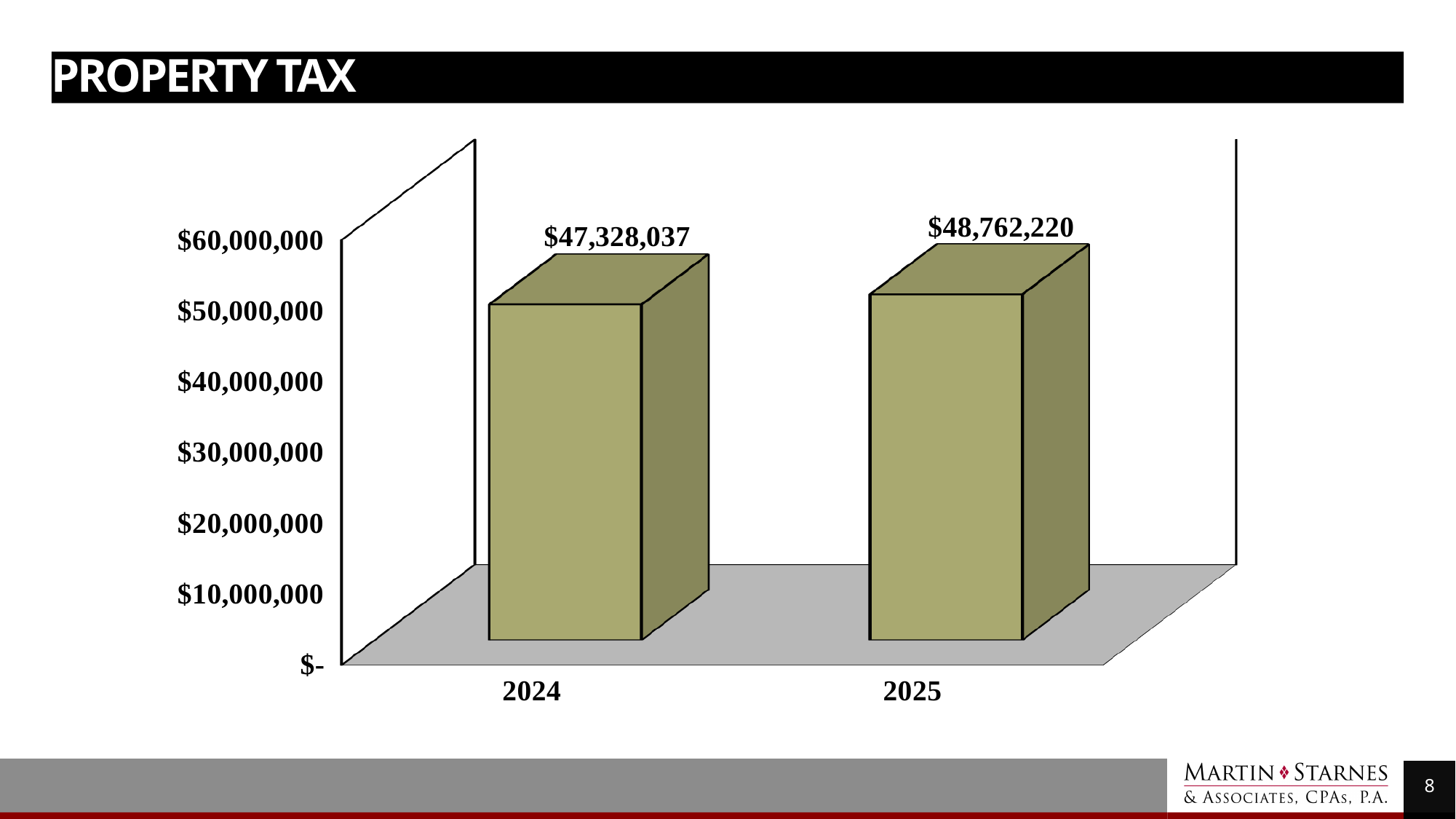
What is the title of the slide containing the chart? PROPERTY TAX Which year has the higher property tax value? 2025 What is the difference between the 2025 and 2024 property tax values? $1,434,183 Which year has the lower property tax value? 2024 Is the property tax value for 2024 larger or smaller than the value for 2025? smaller What is the property tax value for 2025? $48,762,220 What kind of chart is shown on the slide? bar chart How many years are shown on the chart? 2 Is the property tax value for 2025 greater or less than $40,000,000? greater What is the property tax value for 2024? $47,328,037 Do the property tax values rise or fall from 2024 to 2025? rise Is the property tax value for 2024 greater or less than $50,000,000? less